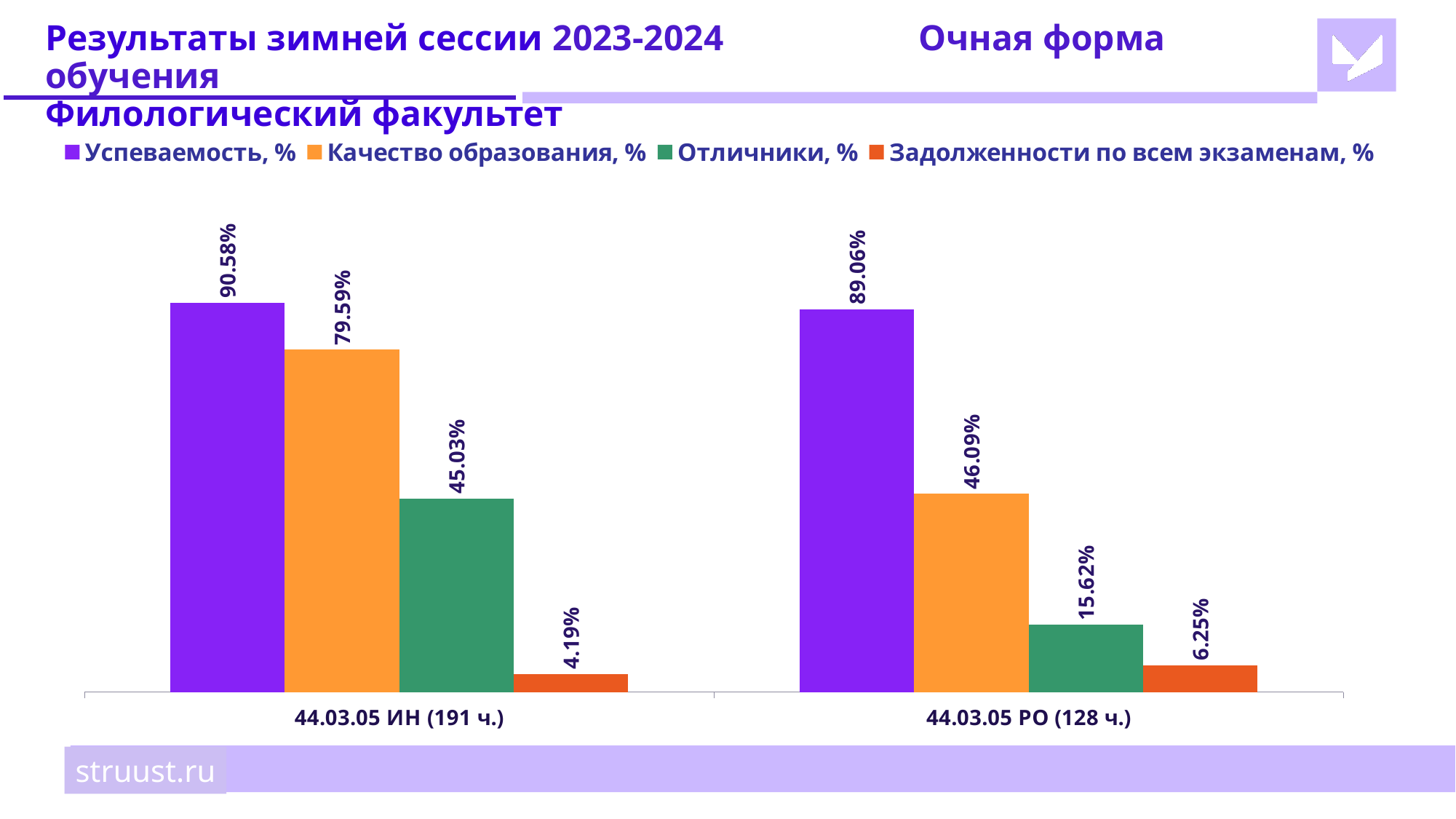
What is the value of Успеваемость, % for 44.03.05 ИН (191 ч.)? 90.58% Which category has the lower value for Задолженности по всем экзаменам, %? 44.03.05 ИН (191 ч.) What is the value of Отличники, % for 44.03.05 ИН (191 ч.)? 45.03% Which category has the higher value for Отличники, %? 44.03.05 ИН (191 ч.) What is the difference between Качество образования, % for 44.03.05 ИН (191 ч.) and for 44.03.05 РО (128 ч.)? 33.5% What is the value of Качество образования, % for 44.03.05 РО (128 ч.)? 46.09% How many series does the legend list? 4 What kind of chart is shown on the slide? Bar chart How many categories are shown on the x axis? 2 Which colour represents Отличники, % in the legend? Green Which is larger: Успеваемость, % for 44.03.05 ИН (191 ч.) or for 44.03.05 РО (128 ч.)? 44.03.05 ИН (191 ч.) What is the value of Задолженности по всем экзаменам, % for 44.03.05 РО (128 ч.)? 6.25%